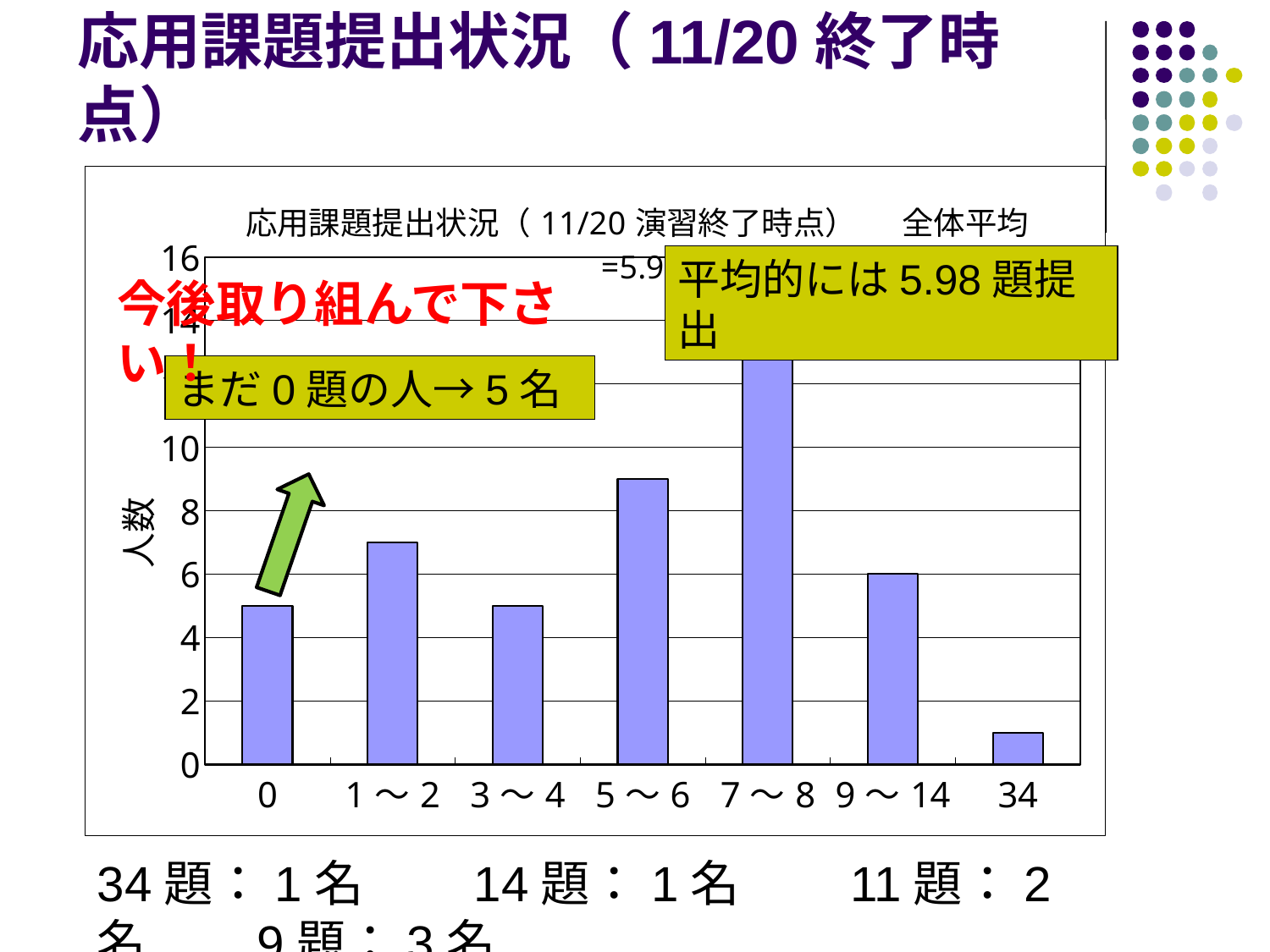
What kind of chart is shown on the slide? bar chart Which category has a larger value, 5～6 or 3～4? 5～6 How many categories are shown on the x axis of the chart? 7 Which category has the highest bar in the chart? 7～8 How many people (人数) are in the 9～14 category? 6 Is the value for 5～6 greater or less than 8? greater What is the overall average (全体平均) number of submitted problems stated on the slide? 5.98 How many people (人数) are in the 34 category? 1 Is the value for 7～8 greater or less than 12? greater Which category has the lowest bar in the chart? 34 How many people (人数) are in the 0 category? 5 Is the value for 1～2 greater or less than 6? greater